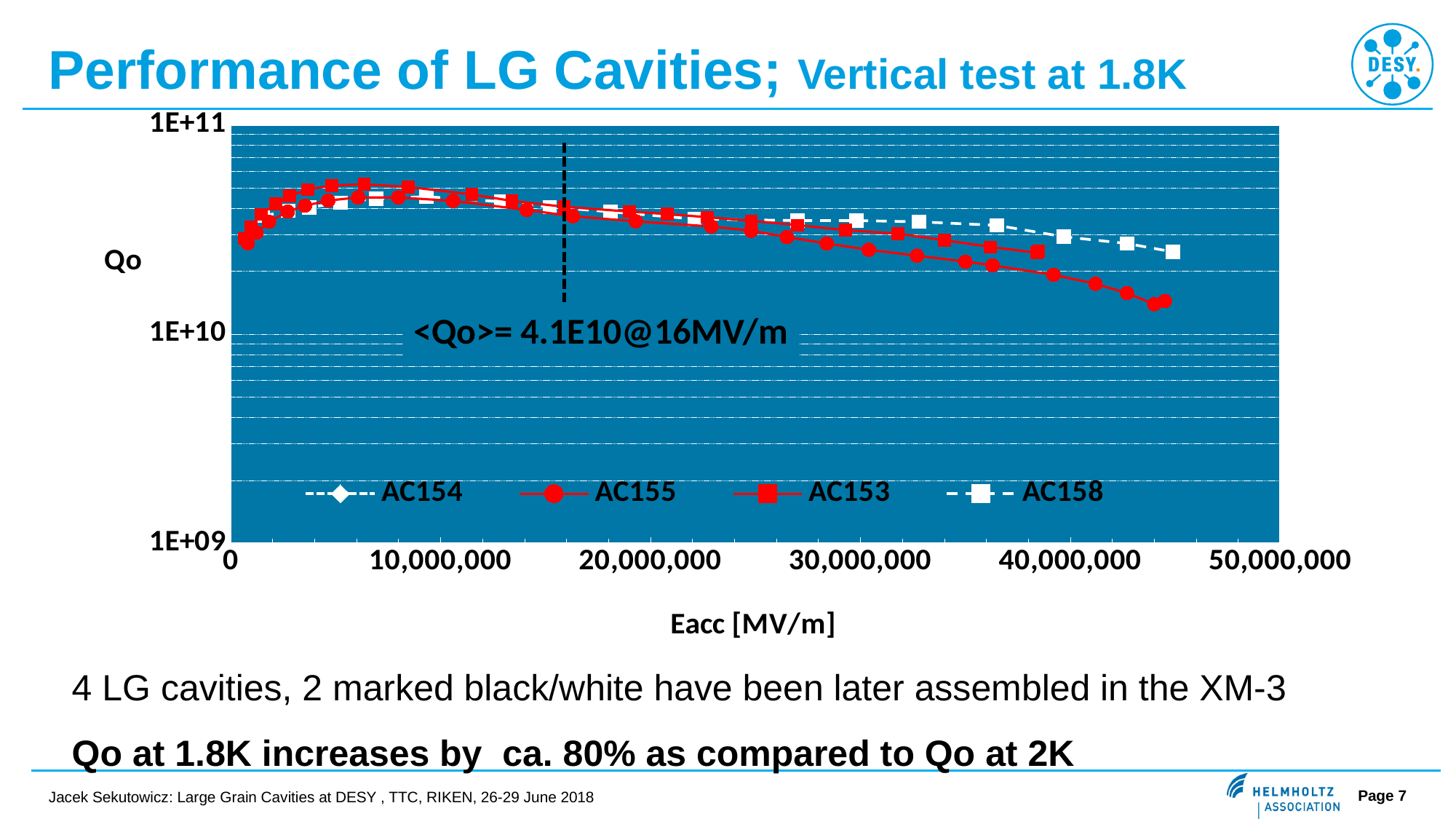
Do the Qo values for AC155 rise or fall as Eacc increases beyond 20,000,000? fall Is the Qo value for AC158 at its highest Eacc point greater or less than 1E+10? greater Which series are listed in the chart legend? AC154, AC155, AC153, AC158 Are any of the plotted Qo values greater than 1E+11? No Which series has the highest Qo at the right-hand end of the chart (around 45,000,000)? AC158 What kind of chart is shown on the slide? line chart Is the Qo value for AC155 at its highest Eacc point greater or less than 1E+10? greater What average Qo value is annotated on the chart at 16 MV/m? 4.1E10 What is the label of the y axis of the chart? Qo How many series does the chart legend list? 4 At an Eacc of about 40,000,000, which series has the higher Qo, AC158 or AC155? AC158 What is the label of the x axis of the chart? Eacc [MV/m]